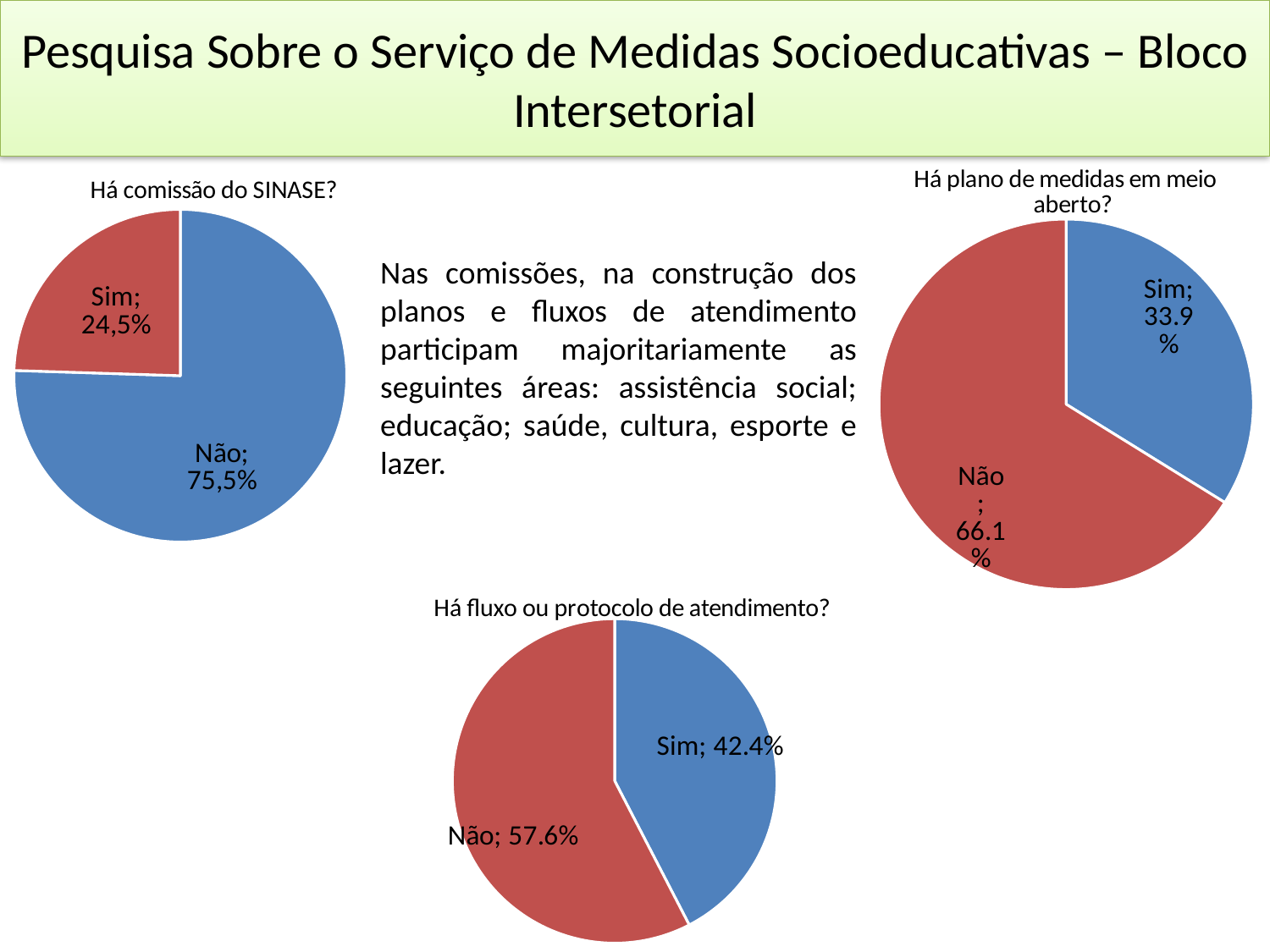
What kind of chart is 'Há comissão do SINASE?'? Pie chart In the 'Há plano de medidas em meio aberto?' chart, what percentage is shown for 'Sim'? 33.9% In the 'Há comissão do SINASE?' chart, which slice is the largest? Não In the 'Há fluxo ou protocolo de atendimento?' chart, what is the difference between the 'Não' and 'Sim' percentages? 15.2% In the 'Há fluxo ou protocolo de atendimento?' chart, what percentage is shown for 'Sim'? 42.4% In the 'Há comissão do SINASE?' chart, what percentage is shown for 'Sim'? 24,5% How many slices does the 'Há plano de medidas em meio aberto?' chart have? 2 In the 'Há plano de medidas em meio aberto?' chart, what percentage is shown for 'Não'? 66.1% In the 'Há plano de medidas em meio aberto?' chart, which is larger, 'Sim' or 'Não'? Não In the 'Há fluxo ou protocolo de atendimento?' chart, what percentage is shown for 'Não'? 57.6% In the 'Há fluxo ou protocolo de atendimento?' chart, which slice is the smallest? Sim In the 'Há comissão do SINASE?' chart, what percentage is shown for 'Não'? 75,5%